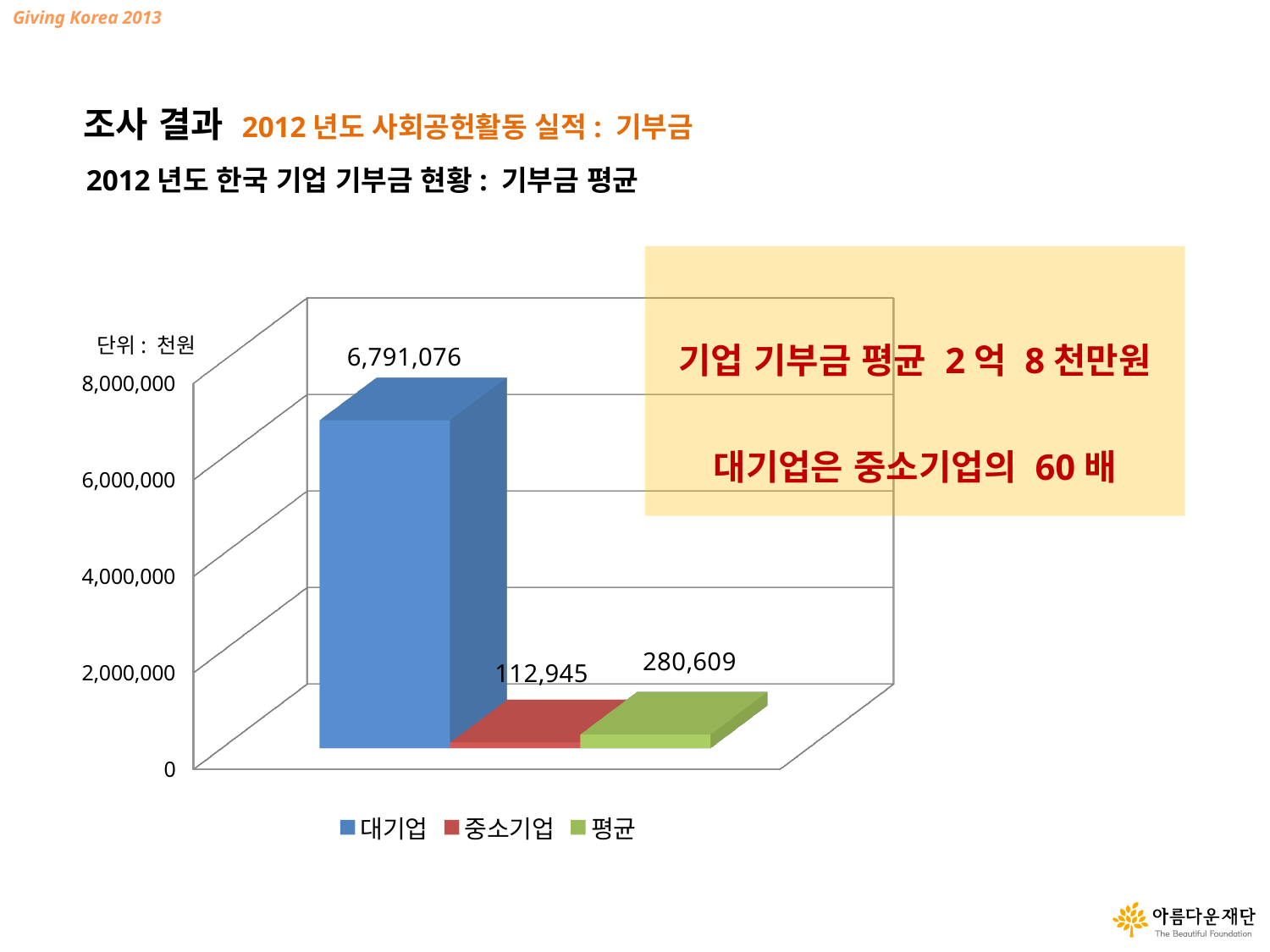
Which series has the lowest value? 중소기업 What is the value shown for 평균? 280,609 Which is larger, the value for 평균 or the value for 중소기업? 평균 What kind of chart is shown on the slide? bar chart What is the difference between the values for 평균 and 중소기업? 167,664 Is the value for 대기업 greater or less than 6,000,000? greater What is the value shown for 대기업? 6,791,076 How many series does the legend list? 3 What is the value shown for 중소기업? 112,945 Which series has the highest value? 대기업 What unit is stated for the values in the chart? 천원 What is the difference between the values for 대기업 and 중소기업? 6,678,131